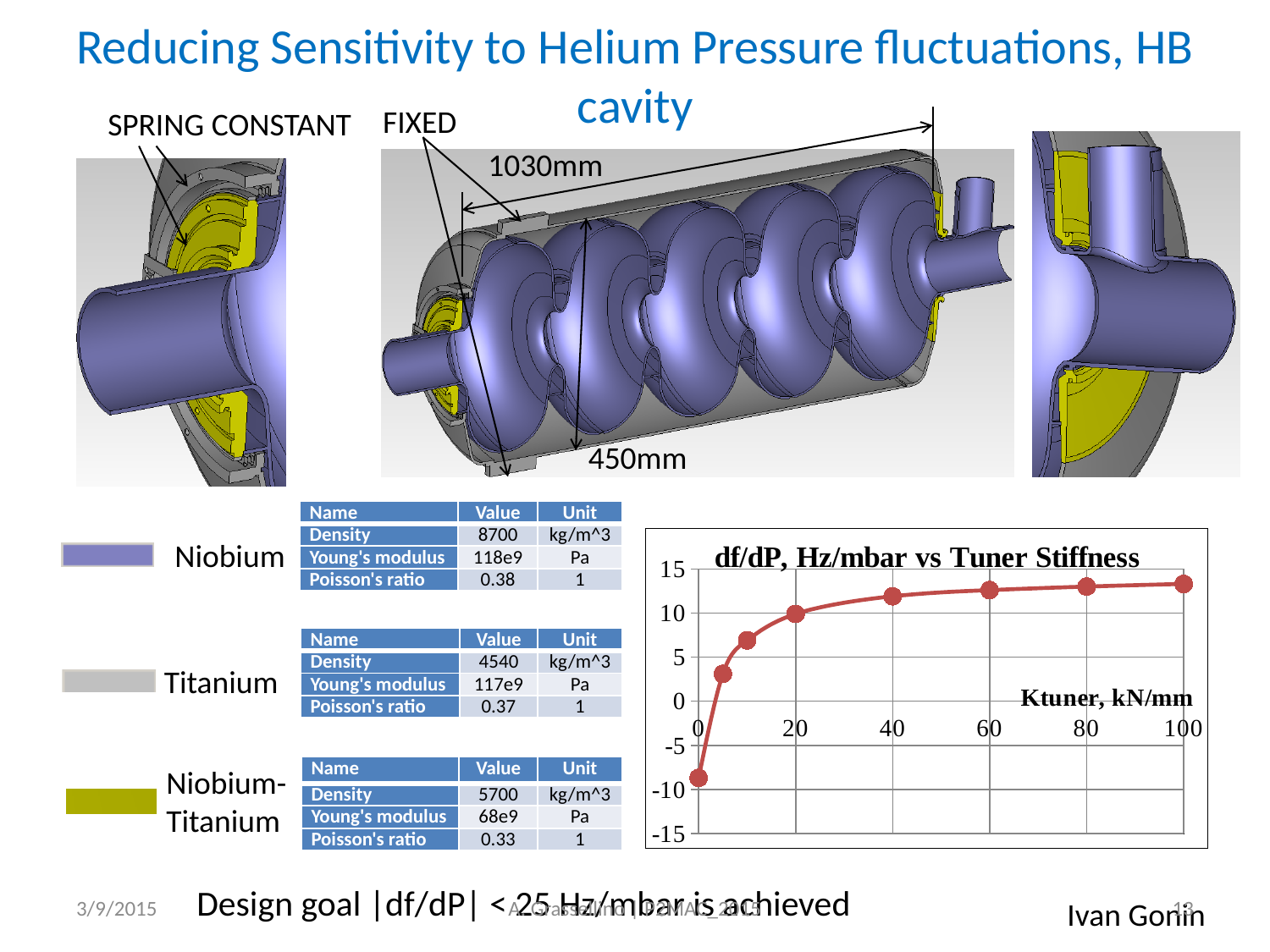
Which is larger, the df/dP value at Ktuner = 0 or at Ktuner = 20? Ktuner = 20 At which Ktuner value is df/dP lowest? 0 Is the df/dP value at Ktuner = 100 greater or less than 10? greater Is the df/dP value at Ktuner = 20 greater or less than 5? greater Is the df/dP value at Ktuner = 40 greater or less than 15? less Which is larger, the df/dP value at Ktuner = 10 or at Ktuner = 60? Ktuner = 60 Do the df/dP values rise or fall as Ktuner increases along the x axis? rise What is the title of the chart? df/dP, Hz/mbar vs Tuner Stiffness What kind of chart is shown on the slide? line chart How many data points are plotted on the chart? 8 What is the label of the x axis of the chart? Ktuner, kN/mm